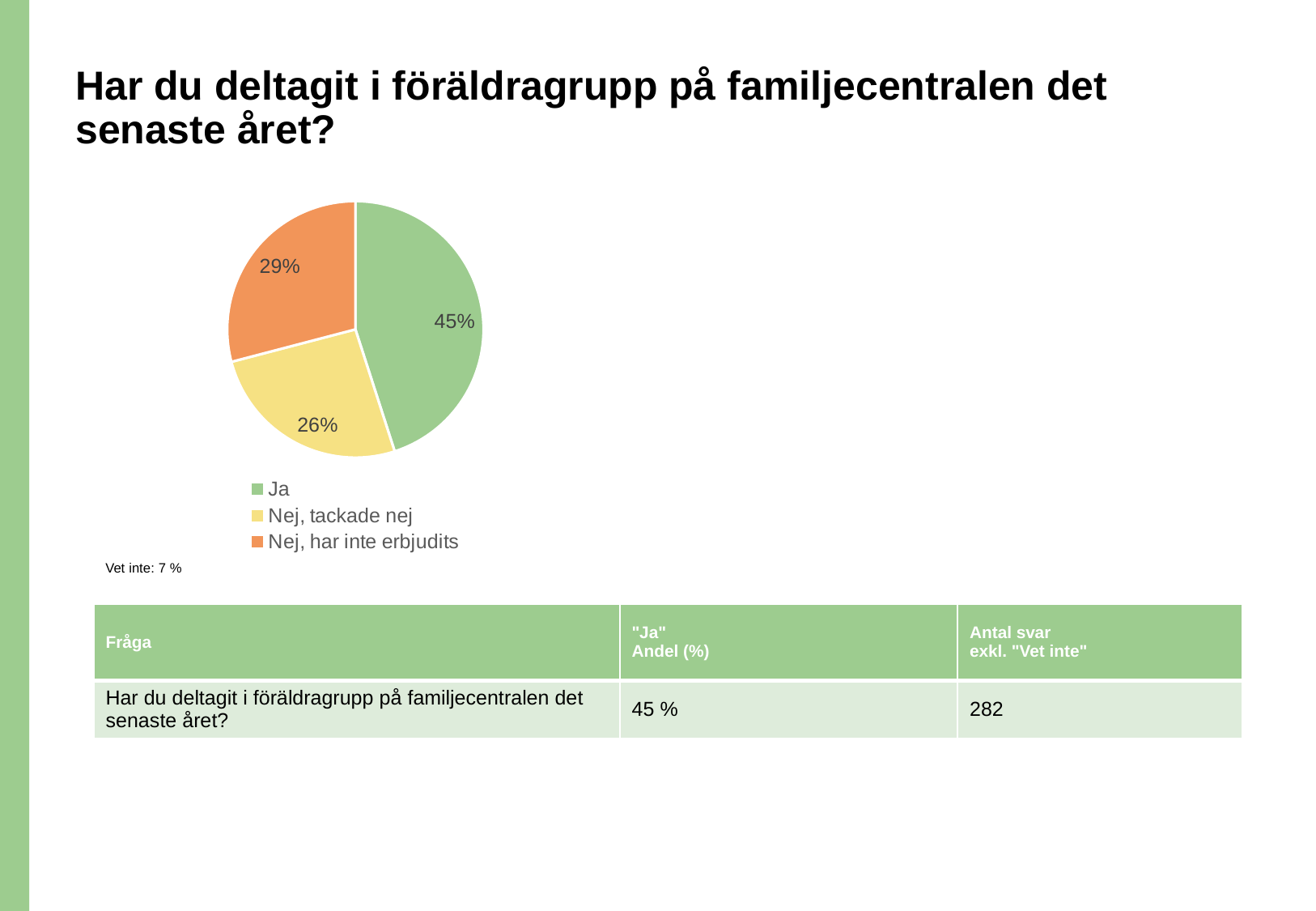
Which is larger, the "Nej, tackade nej" slice or the "Nej, har inte erbjudits" slice? Nej, har inte erbjudits Which category has the largest slice of the pie? Ja How many entries does the legend list? 3 What is the difference in percentage points between the "Ja" slice and the "Nej, har inte erbjudits" slice? 16 What percentage is given for "Vet inte" below the chart? 7 % What share of the pie does "Ja" have? 45% How many slices does the pie chart have? 3 Which category has the smallest slice of the pie? Nej, tackade nej What share of the pie does "Nej, har inte erbjudits" have? 29% What kind of chart is shown on the slide? pie chart What colour is the "Ja" slice in the pie chart? green What share of the pie does "Nej, tackade nej" have? 26%